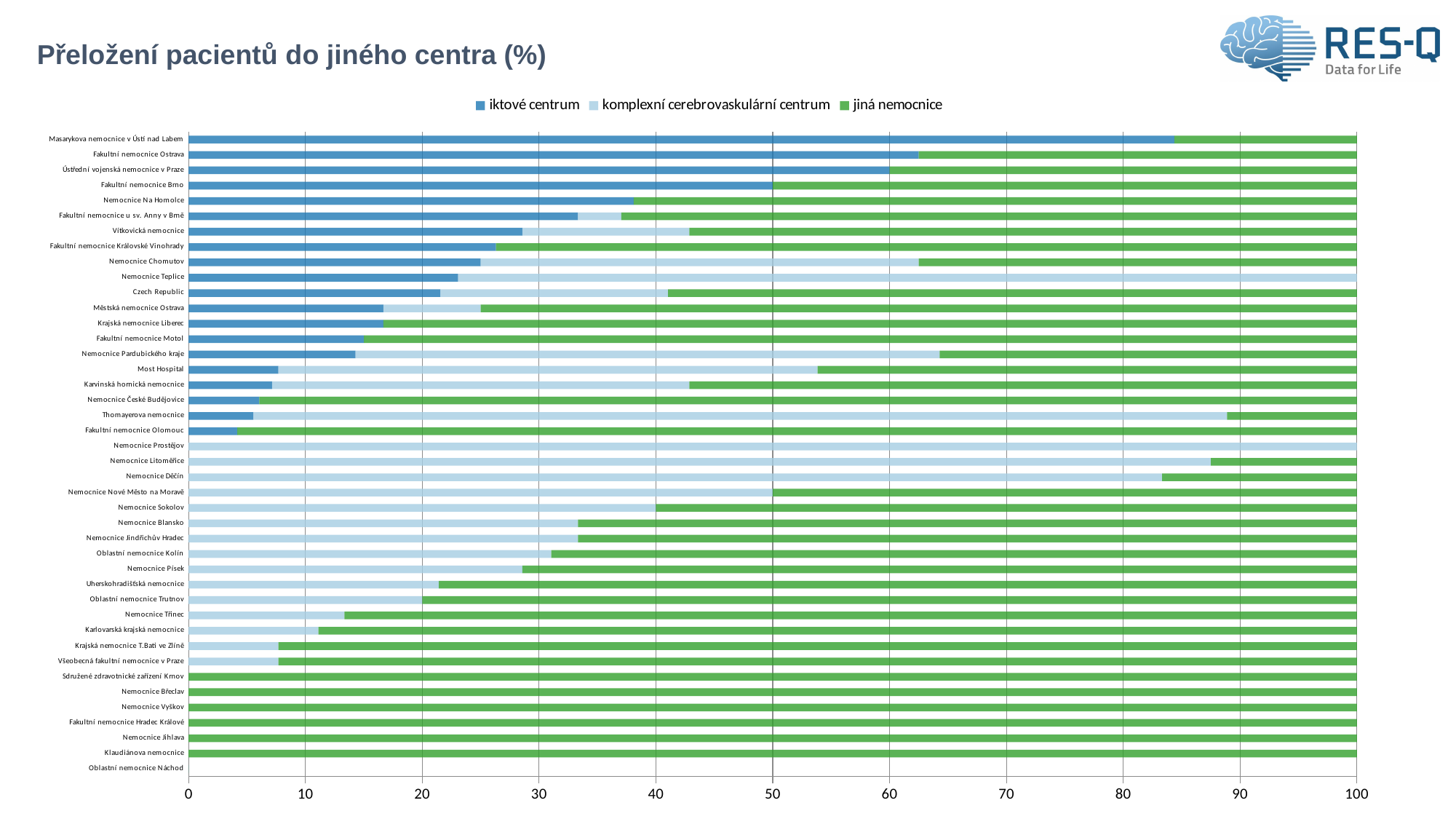
What is the title of the chart? Přeložení pacientů do jiného centra (%) How many hospitals (categories) are listed on the vertical axis? 42 What is the iktové centrum value for Fakultní nemocnice Brno? 50 Which hospital has the largest share for iktové centrum? Masarykova nemocnice v Ústí nad Labem What are the three series named in the legend? iktové centrum, komplexní cerebrovaskulární centrum, jiná nemocnice Is the iktové centrum value for Masarykova nemocnice v Ústí nad Labem greater or less than 80? greater What is the iktové centrum value for Ústřední vojenská nemocnice v Praze? 60 What kind of chart is shown on the slide? bar chart Is the iktové centrum value for Nemocnice Na Homolce greater or less than 40? less Which is larger, the iktové centrum value for Fakultní nemocnice Ostrava or for Vítkovická nemocnice? Fakultní nemocnice Ostrava What is the komplexní cerebrovaskulární centrum value for Nemocnice Sokolov? 40 How many series does the legend list? 3